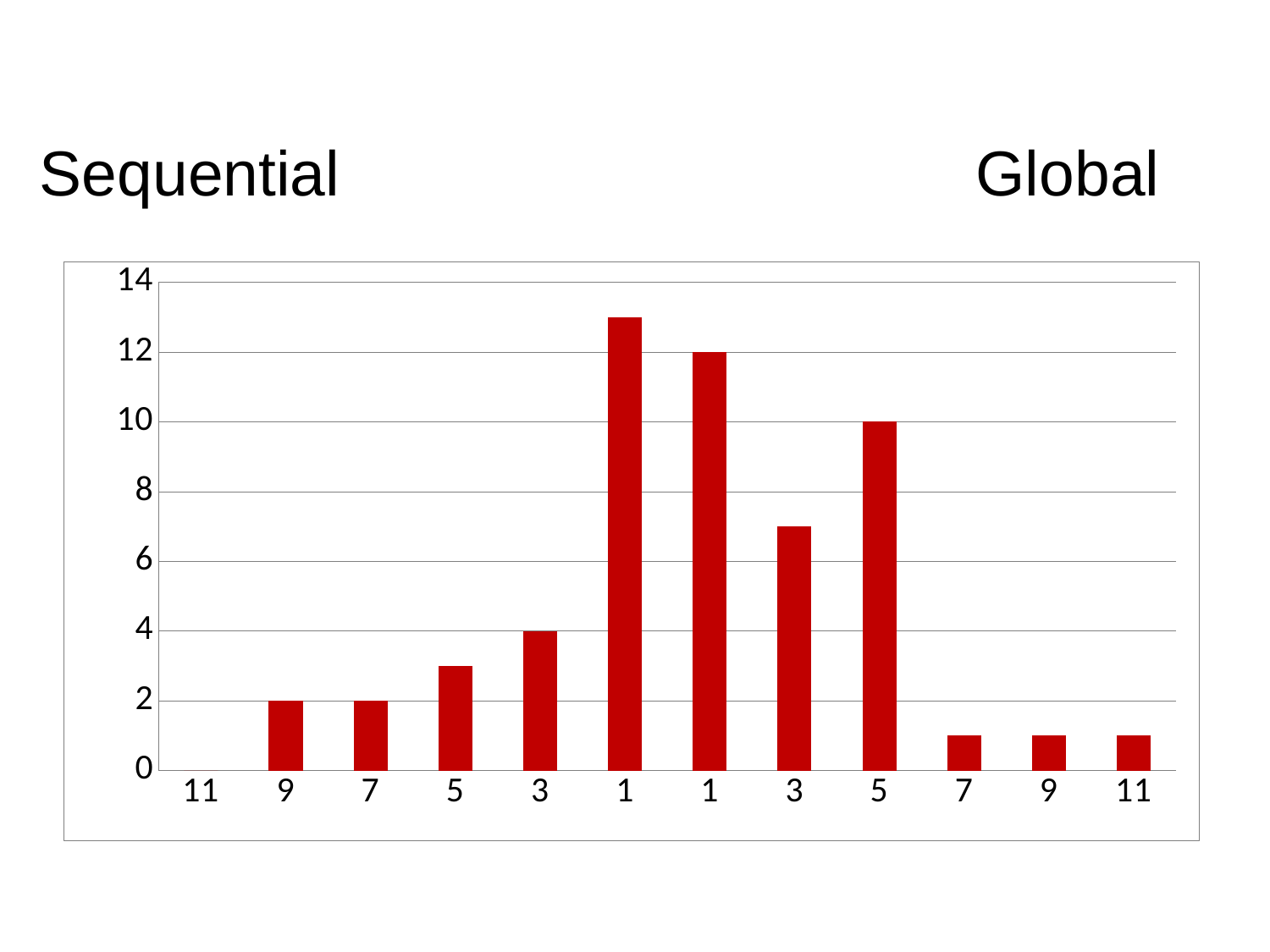
Is the value of the right-hand bar labelled 3 greater or less than 6? greater What is the value of the right-hand bar labelled 5? 10 Is the value of the left-hand bar labelled 7 greater or less than 4? less What is the value of the left-hand bar labelled 3? 4 Is the value of the left-hand bar labelled 1 greater or less than 12? greater Which category has the tallest bar? the left-hand bar labelled 1 (sixth from the left) Which is larger: the right-hand bar labelled 5 or the right-hand bar labelled 3? the right-hand bar labelled 5 How many bars (categories) are plotted along the x axis? 12 What kind of chart is shown on the slide? bar chart What is the difference between the right-hand bar labelled 1 and the left-hand bar labelled 3? 8 What is the value of the right-hand bar labelled 1 (seventh from the left)? 12 What is the value of the left-hand bar labelled 9? 2